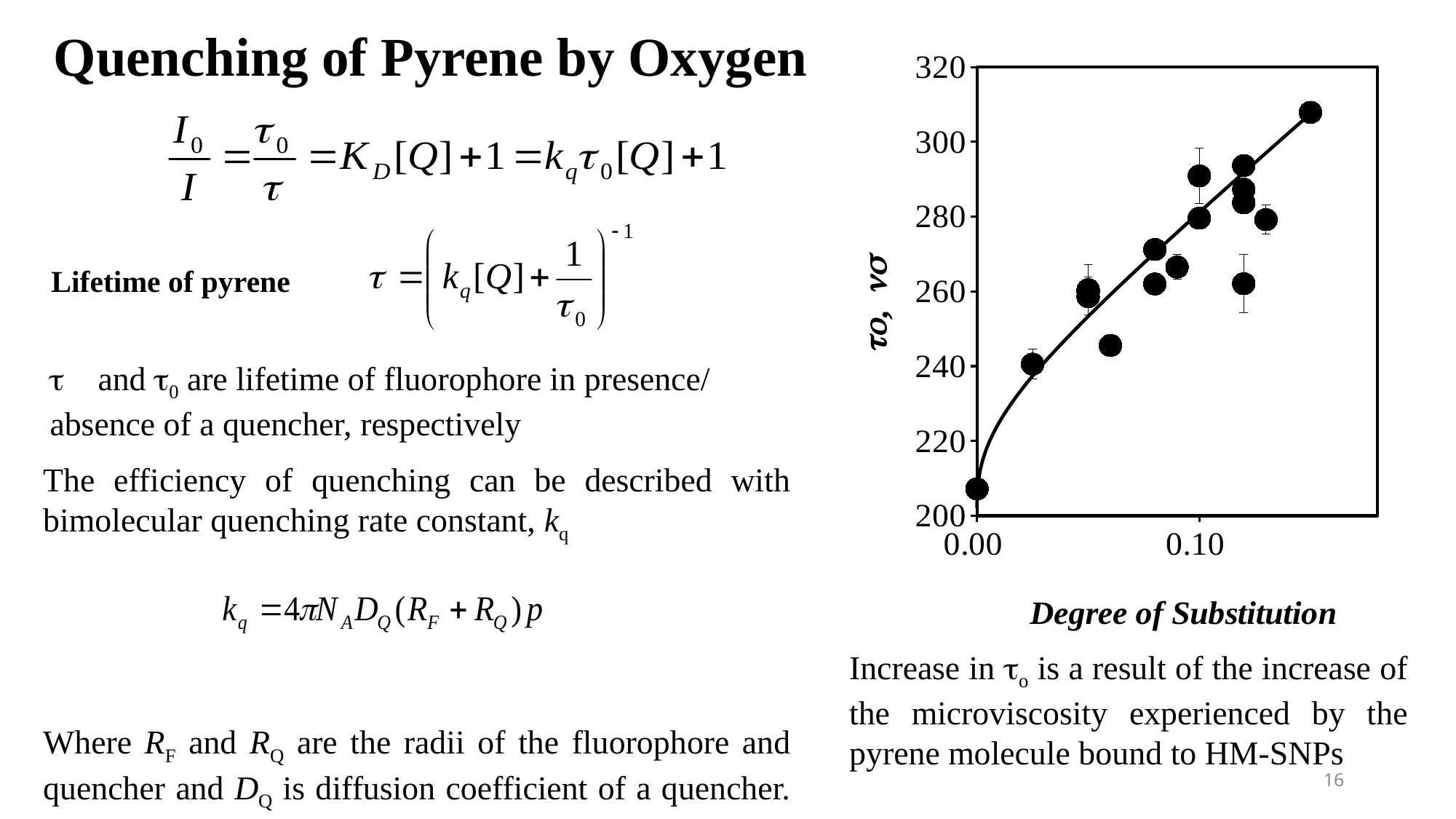
What is the label of the y axis of the chart? τo, νσ Do the τ0 values generally rise or fall as the degree of substitution increases? rise What kind of chart is shown on the slide? scatter plot Is the lowest τ0 value plotted on the chart greater or less than 220? less Is the τ0 value at a degree of substitution of 0.00 larger or smaller than the values at a degree of substitution of 0.10? smaller Are the τ0 values at a degree of substitution of 0.10 greater or less than 260? greater Is the highest τ0 value plotted on the chart greater or less than 300? greater What is the label of the x axis of the chart? Degree of Substitution What is the maximum value shown on the y axis of the chart? 320